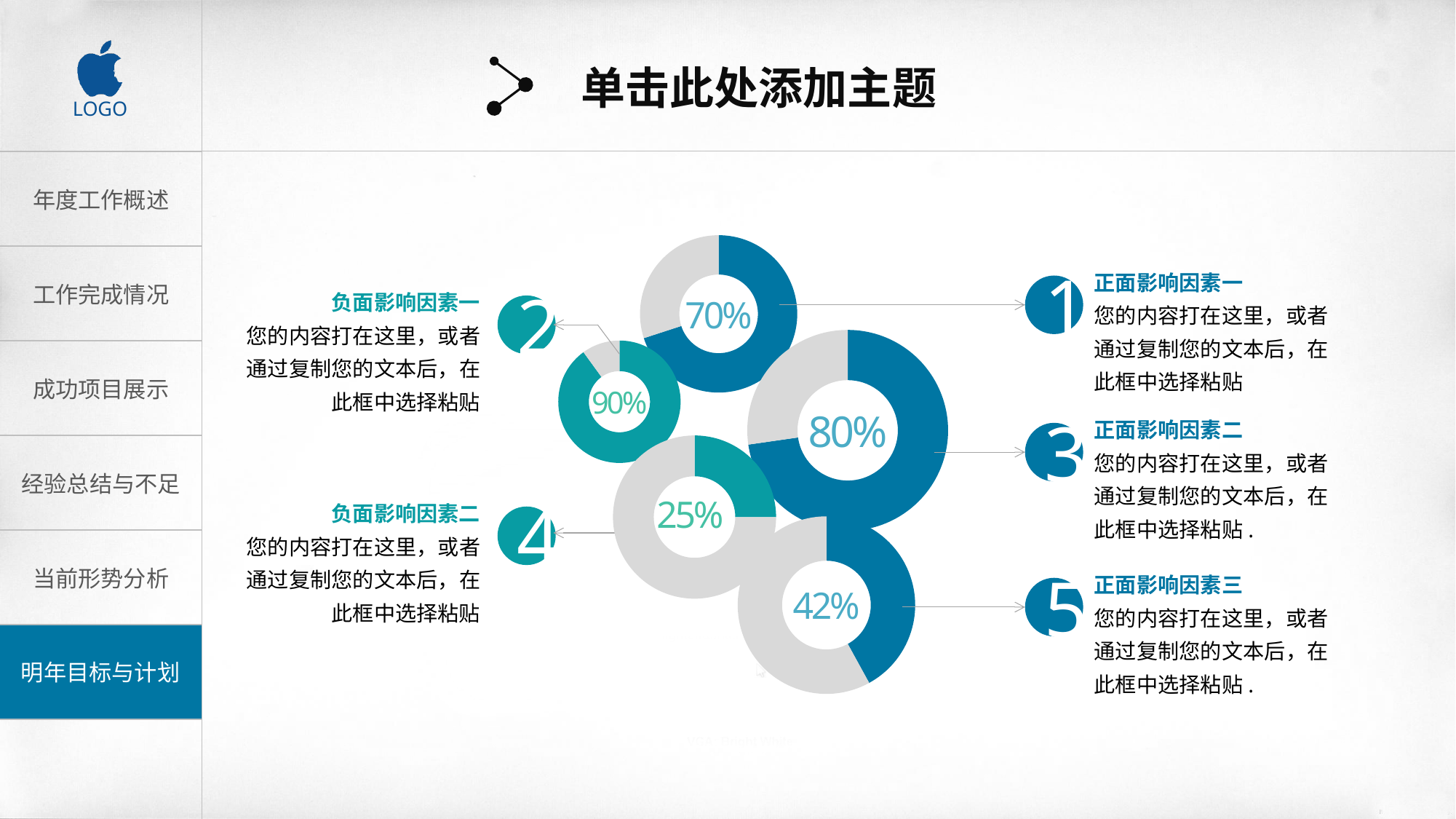
Which is larger: the percentage for 正面影响因素一 or the percentage for 负面影响因素二? 正面影响因素一 Which of the five donut charts shows the highest percentage? 90% Which of the five donut charts shows the lowest percentage? 25% What percentage is shown in the largest donut chart, linked to 正面影响因素二? 80% What percentage is shown in the donut chart linked to 正面影响因素一? 70% What percentage is shown in the donut chart linked to 负面影响因素二? 25% What kind of chart is used to display the percentages on the slide? Donut chart What is the difference between the percentage for 负面影响因素一 and the percentage for 负面影响因素二? 65% What percentage is shown in the donut chart linked to 负面影响因素一? 90% What percentage is shown in the bottom donut chart, linked to 正面影响因素三? 42% How many donut charts are shown on the slide? 5 What is the difference between the percentage for 正面影响因素二 and the percentage for 正面影响因素三? 38%